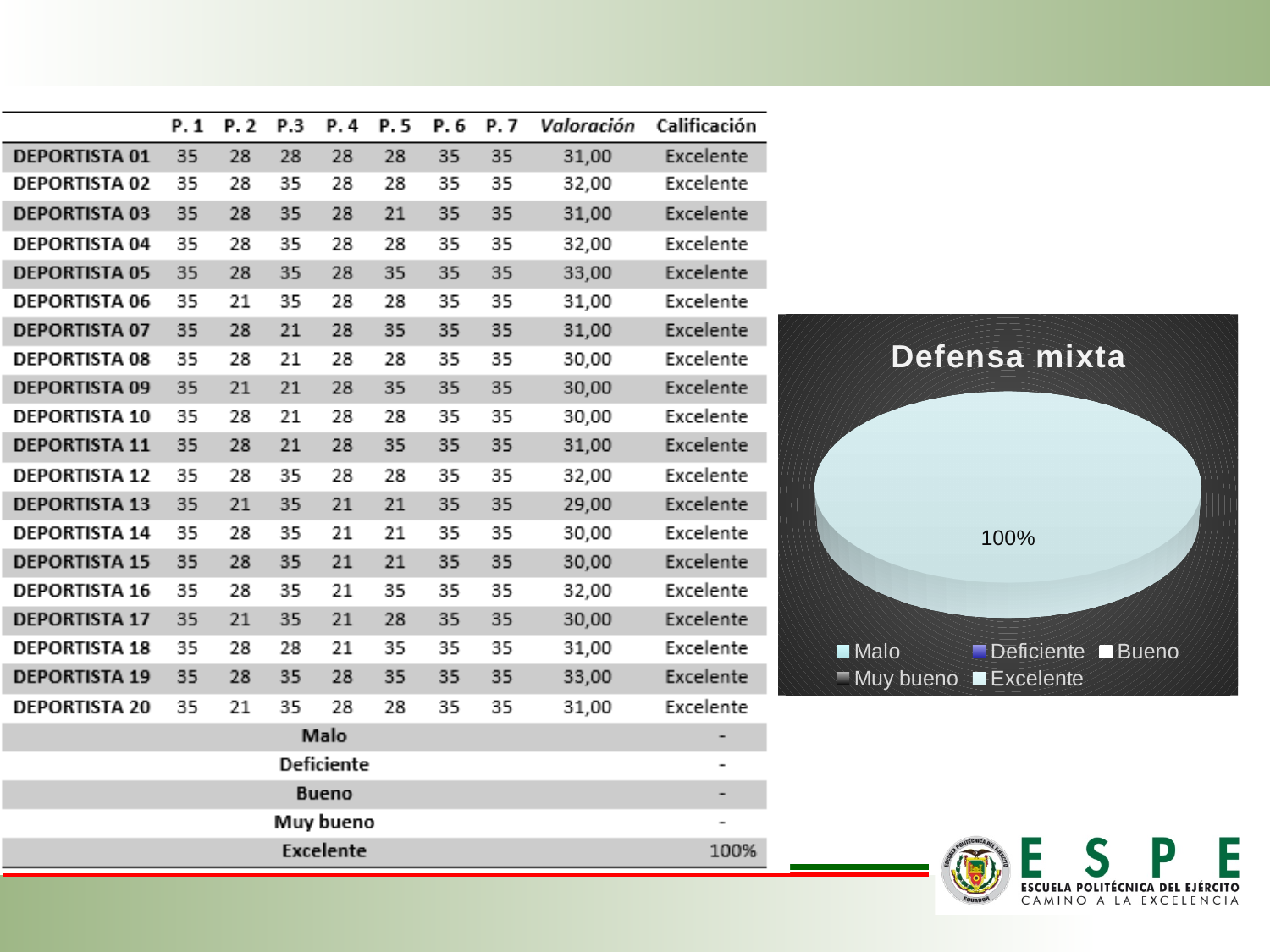
Which category accounts for the whole "Defensa mixta" pie? Excelente How many entries does the legend of the "Defensa mixta" chart list? 5 What share of the "Defensa mixta" pie does the Excelente category have? 100% How many visible slices does the "Defensa mixta" pie chart have? 1 Which legend entries of the "Defensa mixta" chart are listed before Excelente? Malo, Deficiente, Bueno, Muy bueno What is the title of the pie chart on the slide? Defensa mixta Is the share of the Excelente slice in the "Defensa mixta" chart greater or less than 50%? greater What percentage is printed on the single slice of the "Defensa mixta" pie chart? 100% What kind of chart is shown on the slide? pie chart